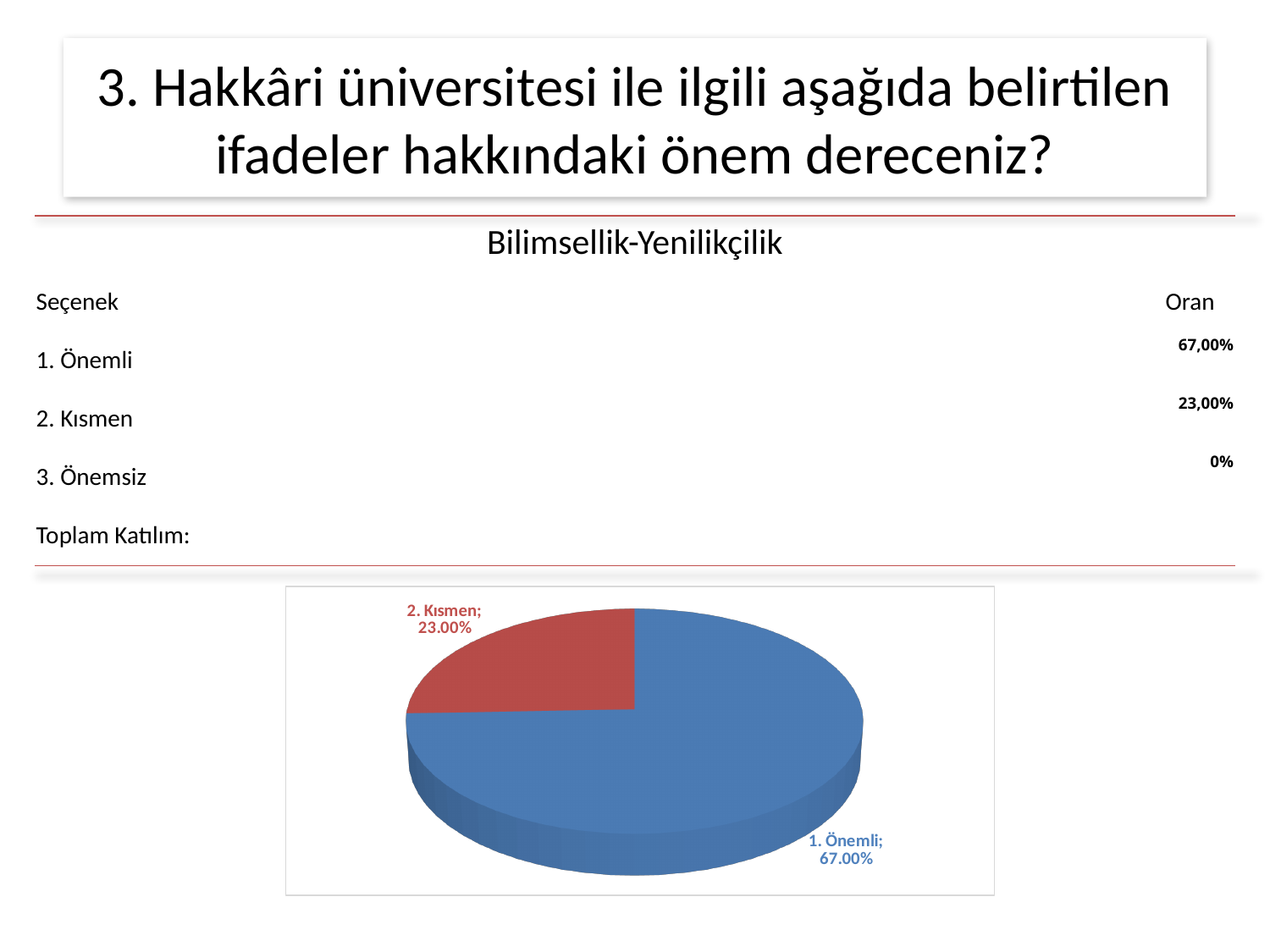
Is the value for "2. Kısmen" in the pie chart greater or less than 50%? less Which slice of the pie chart is the largest? 1. Önemli What kind of chart is shown on the slide? pie chart What colour is the "2. Kısmen" slice in the pie chart? red What is the value shown for the "1. Önemli" slice of the pie chart? 67.00% Which is larger in the pie chart, "1. Önemli" or "2. Kısmen"? 1. Önemli What is the value shown for the "2. Kısmen" slice of the pie chart? 23.00% What colour is the "1. Önemli" slice in the pie chart? blue What is the difference between the "1. Önemli" and "2. Kısmen" values in the pie chart? 44.00% How many labelled slices does the pie chart show? 2 Which labelled slice of the pie chart is the smallest? 2. Kısmen